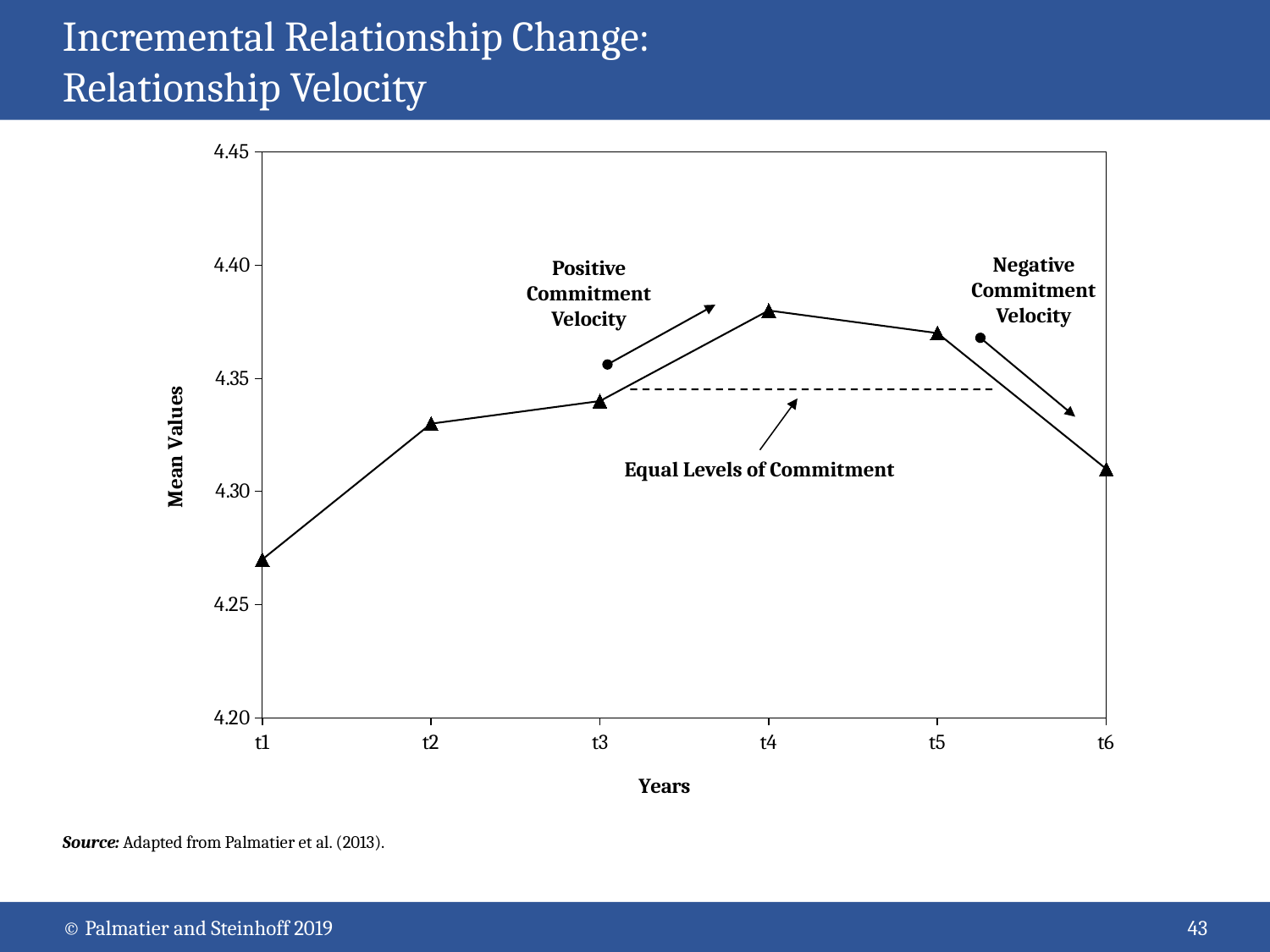
At which time point is the mean value lowest? t1 What is the title of the y axis? Mean Values Is the value at t2 greater or less than 4.30? greater Is the value at t4 greater or less than 4.40? less Which has the larger mean value, t1 or t6? t6 Is the value at t4 greater or less than 4.35? greater What kind of chart is shown on the slide? line chart Do the mean values rise or fall from t4 to t6? fall At which time point is the mean value highest? t4 Do the mean values rise or fall from t1 to t4? rise How many time points are plotted along the x axis? 6